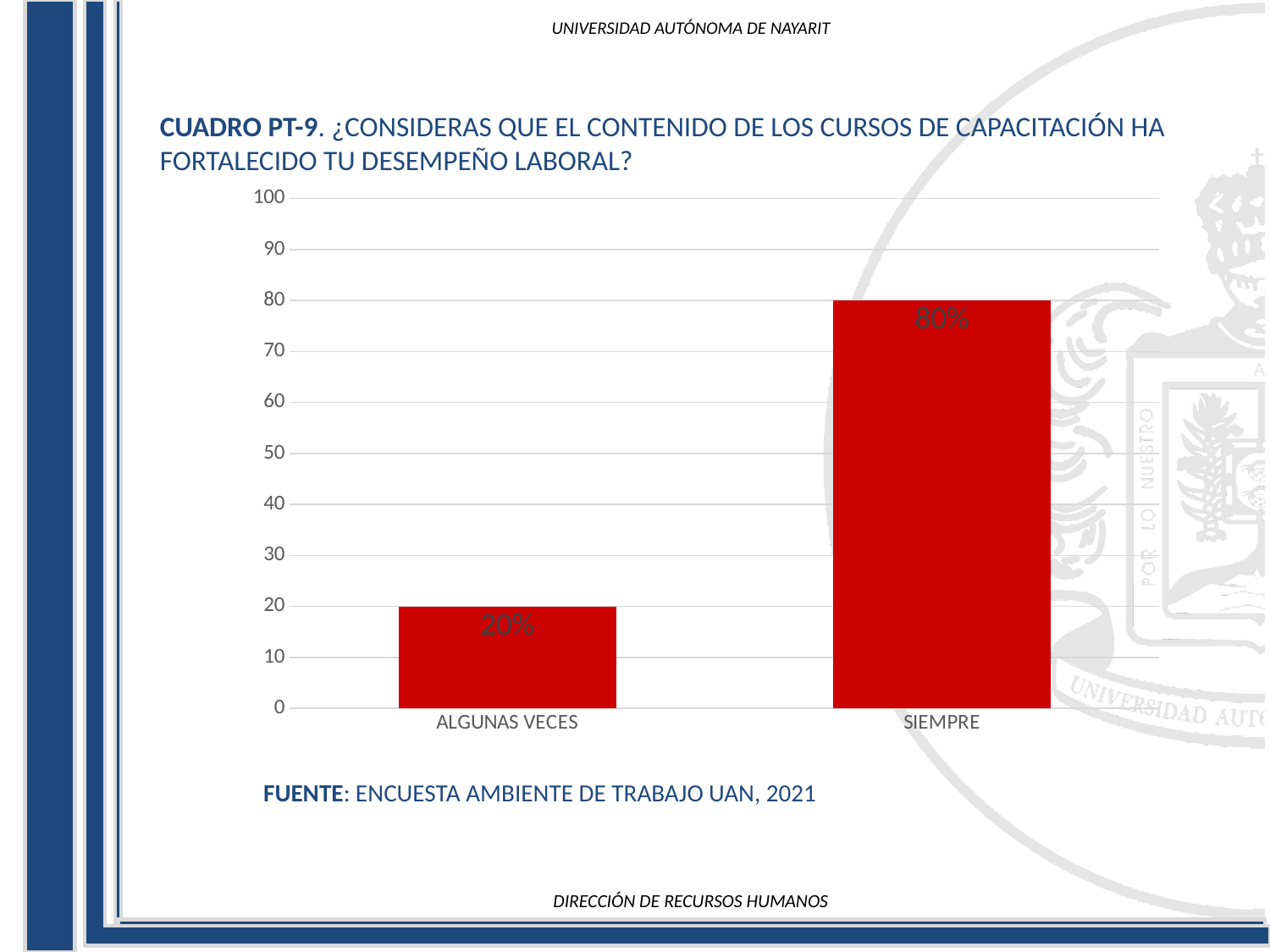
Which category has the highest value? SIEMPRE Is the value for SIEMPRE greater or less than 50? greater What is the value for SIEMPRE? 80% Which is larger, the value for ALGUNAS VECES or the value for SIEMPRE? SIEMPRE Which category has the lowest value? ALGUNAS VECES What kind of chart is shown on the slide? bar chart What colour are the bars in the chart? red What is the difference between the values for SIEMPRE and ALGUNAS VECES? 60% Is the value for ALGUNAS VECES greater or less than 30? less How many categories are shown on the x axis? 2 What is the maximum value shown on the y axis? 100 What is the value for ALGUNAS VECES? 20%